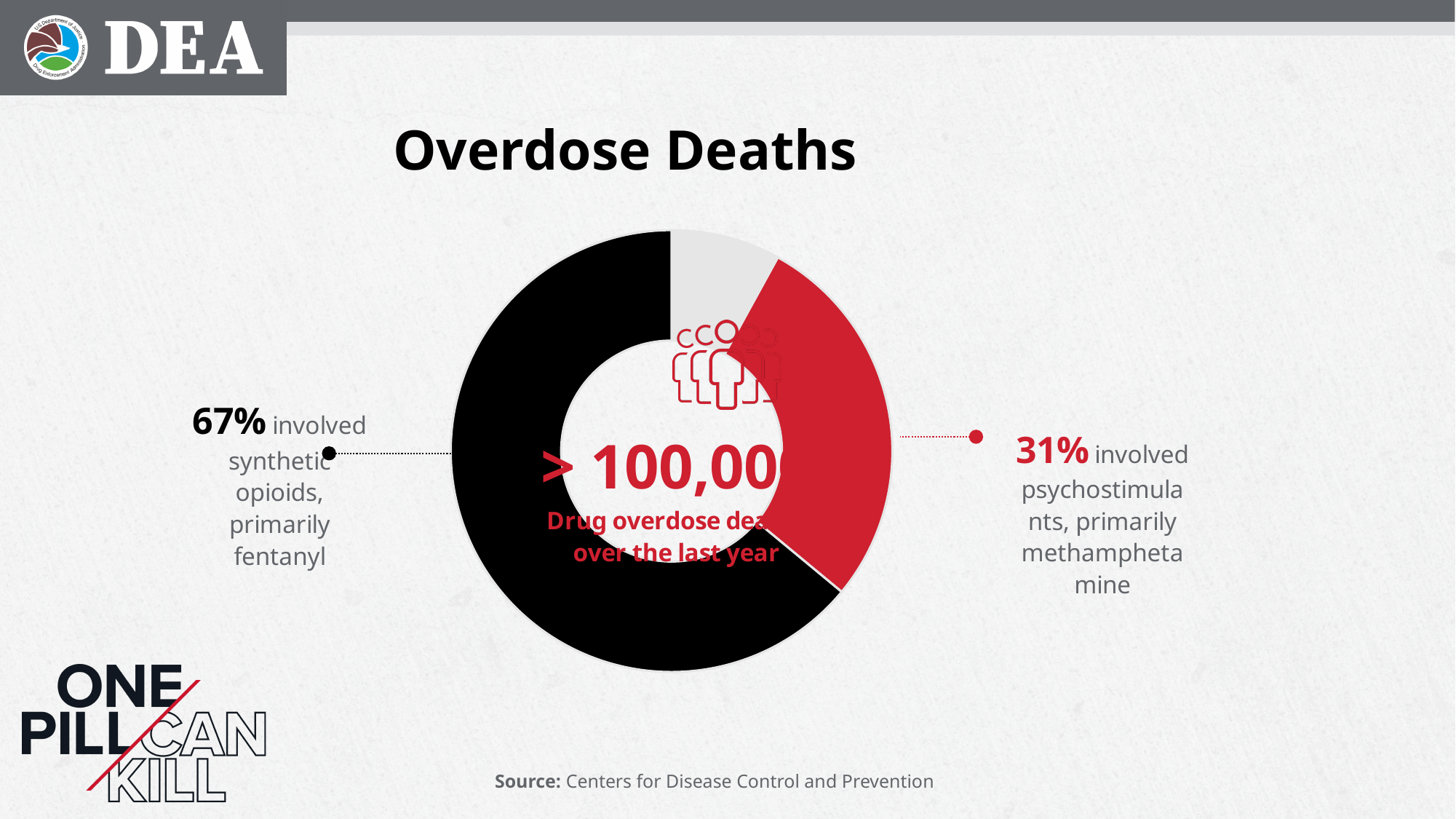
What percentage of overdose deaths involved psychostimulants, primarily methamphetamine? 31% Which labelled category accounts for the largest share of the chart? Synthetic opioids, primarily fentanyl How many slices does the chart have? 3 By how many percentage points does the synthetic opioids share exceed the psychostimulants share? 36 percentage points What is the title of the chart? Overdose Deaths Which is larger, the share for synthetic opioids or the share for psychostimulants? Synthetic opioids What is the source cited for the chart data? Centers for Disease Control and Prevention What kind of chart is shown on the slide? Doughnut chart What colour is the slice representing synthetic opioids? Black Which labelled category accounts for the smaller share: synthetic opioids or psychostimulants? Psychostimulants, primarily methamphetamine What percentage of overdose deaths involved synthetic opioids, primarily fentanyl? 67% What figure is shown in the centre of the chart for drug overdose deaths over the last year? > 100,000